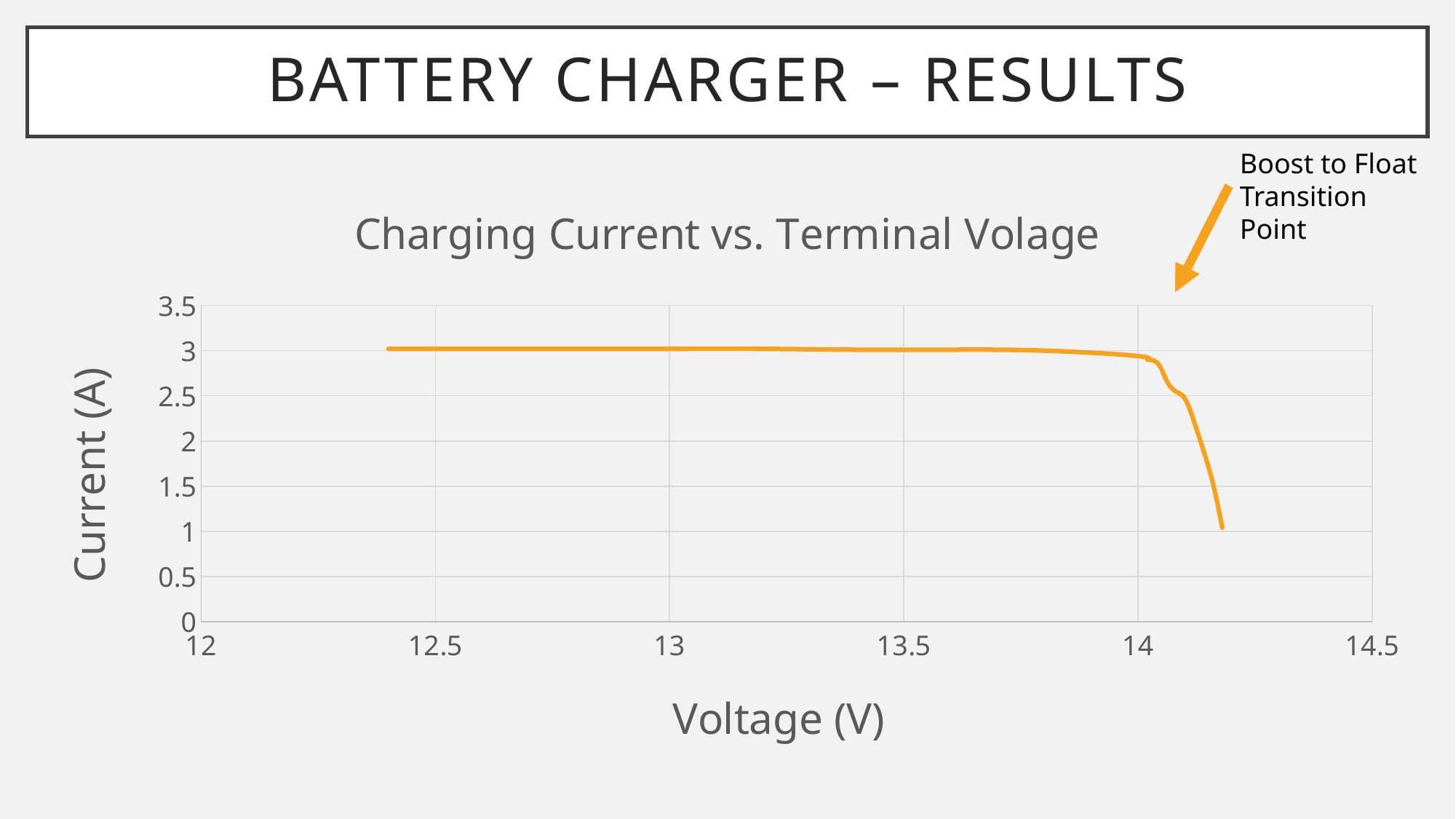
What does the arrow annotation on the chart label? Boost to Float Transition Point Is the current at 12.5 V greater or less than 3.5 A? less At the right-hand end of the line, is the current greater or less than 1.5 A? less Is the current at 13.5 V greater or less than 2 A? greater Is the current at 13 V greater or less than the current at the right-hand end of the line? greater What is the highest value shown on the x axis? 14.5 What kind of chart is shown on the slide? line chart What is the title of the chart? Charging Current vs. Terminal Volage Does the charging current rise or fall as the voltage increases past 14 V? fall